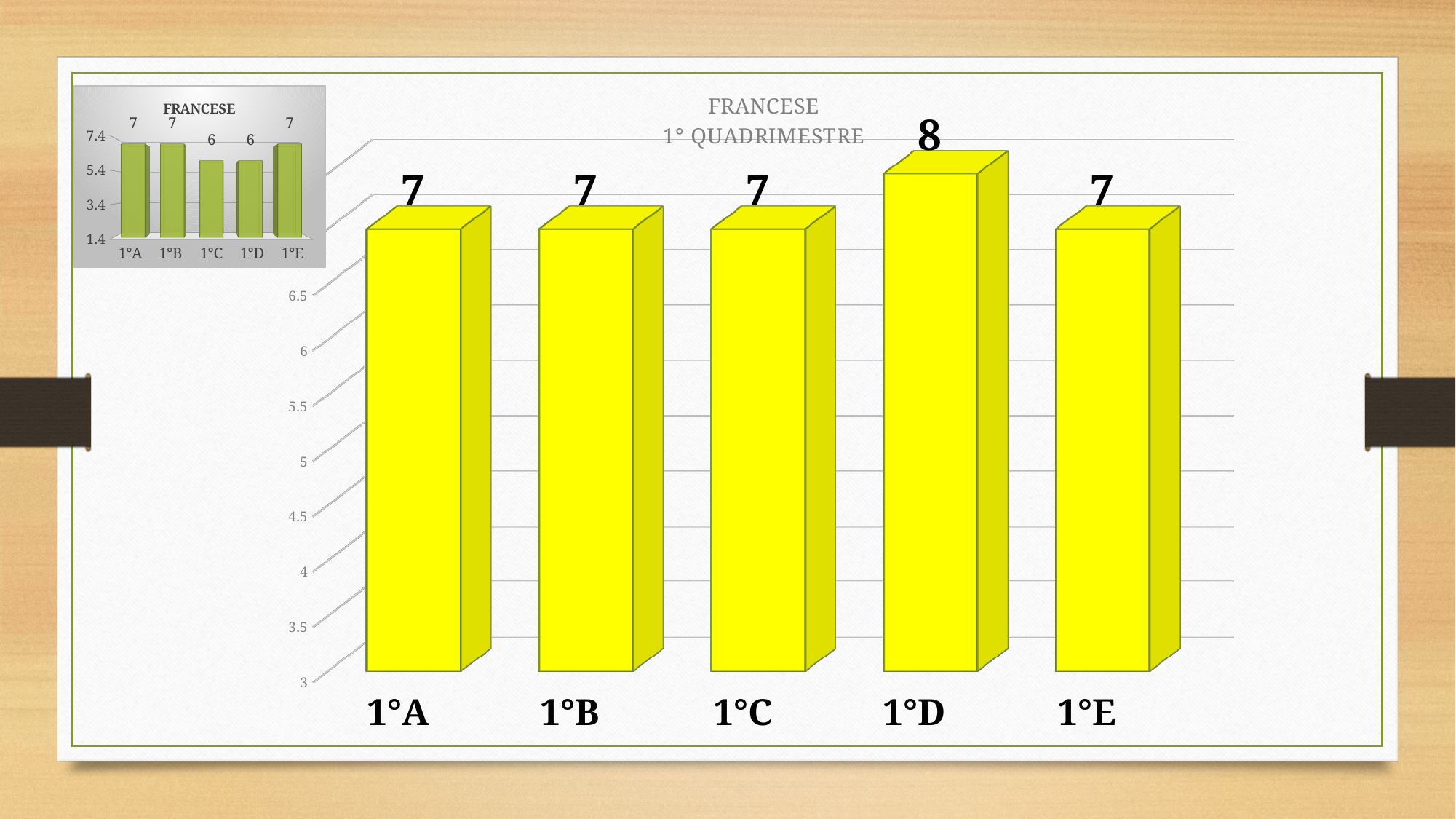
In the large chart titled FRANCESE 1° QUADRIMESTRE, is the value for 1°C greater or less than 5? greater In the small inset chart titled FRANCESE in the top-left corner, what is the value for 1°C? 6 In the large chart titled FRANCESE 1° QUADRIMESTRE, what is the value for 1°D? 8 In the large chart titled FRANCESE 1° QUADRIMESTRE, which is larger, the value for 1°D or the value for 1°B? 1°D In the large chart titled FRANCESE 1° QUADRIMESTRE, which category has the highest value? 1°D In the small inset chart titled FRANCESE in the top-left corner, what is the value for 1°E? 7 In the large chart titled FRANCESE 1° QUADRIMESTRE, how many categories are shown? 5 In the large chart titled FRANCESE 1° QUADRIMESTRE, what is the difference between the values for 1°D and 1°E? 1 In the large chart titled FRANCESE 1° QUADRIMESTRE, what is the value for 1°A? 7 What colour are the bars in the large chart titled FRANCESE 1° QUADRIMESTRE? yellow What kind of chart is the large chart titled FRANCESE 1° QUADRIMESTRE? bar chart In the small inset chart titled FRANCESE in the top-left corner, what is the difference between the values for 1°A and 1°D? 1